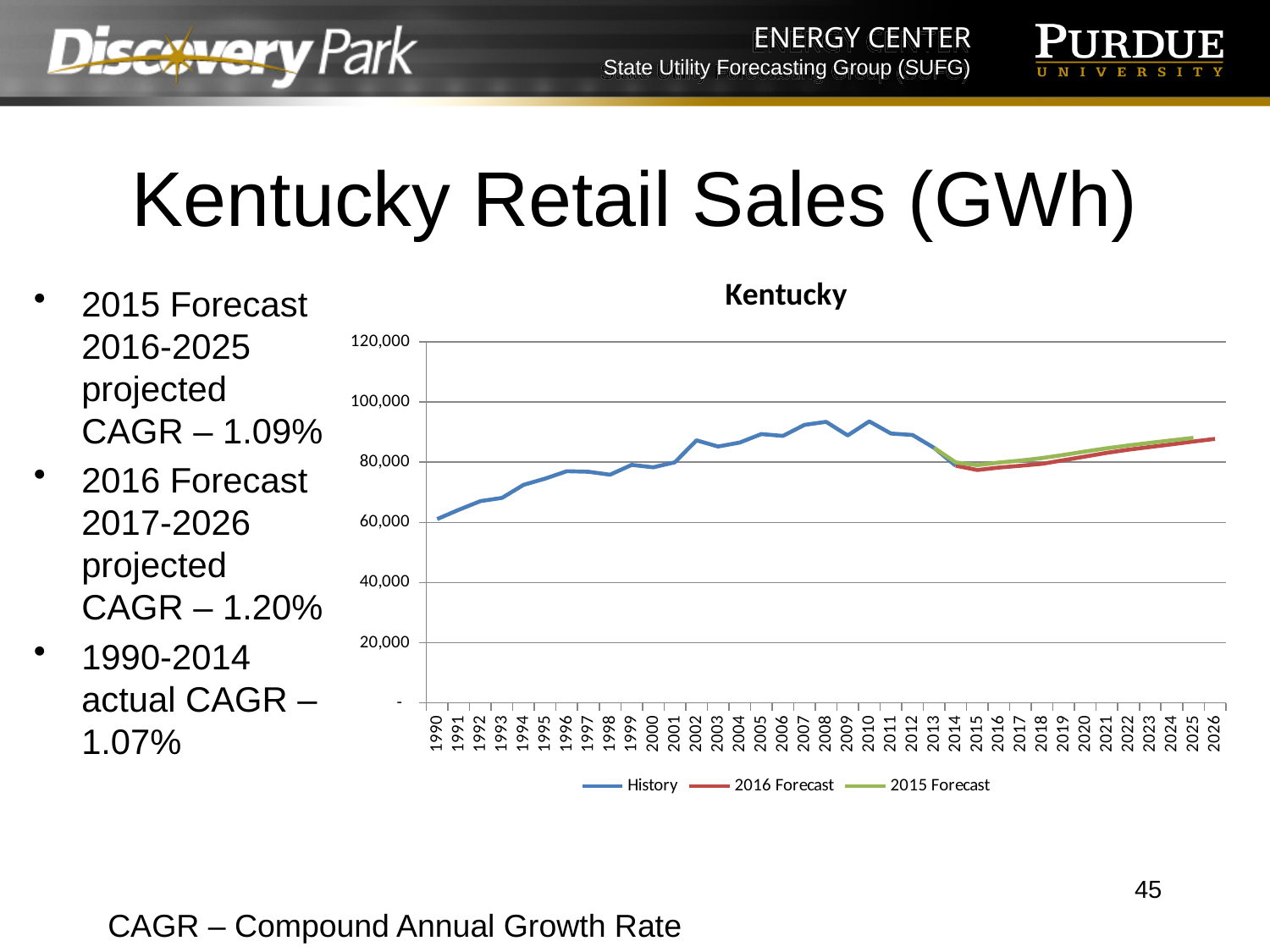
Is the 2016 Forecast value for 2026 greater or less than 100,000? less What are the three series listed in the chart legend? History, 2016 Forecast, 2015 Forecast Does the History series generally rise or fall from 1990 to 2008? rise Which year has the lowest History value? 1990 How many years are labelled on the x axis of the chart? 37 Is the History value for 2008 greater or less than 80,000? greater Which is larger, the History value for 1990 or the History value for 2008? 2008 Is the History value for 1990 greater or less than 80,000? less How many series does the chart legend list? 3 What kind of chart is shown on the slide? line chart What is the title of the chart? Kentucky